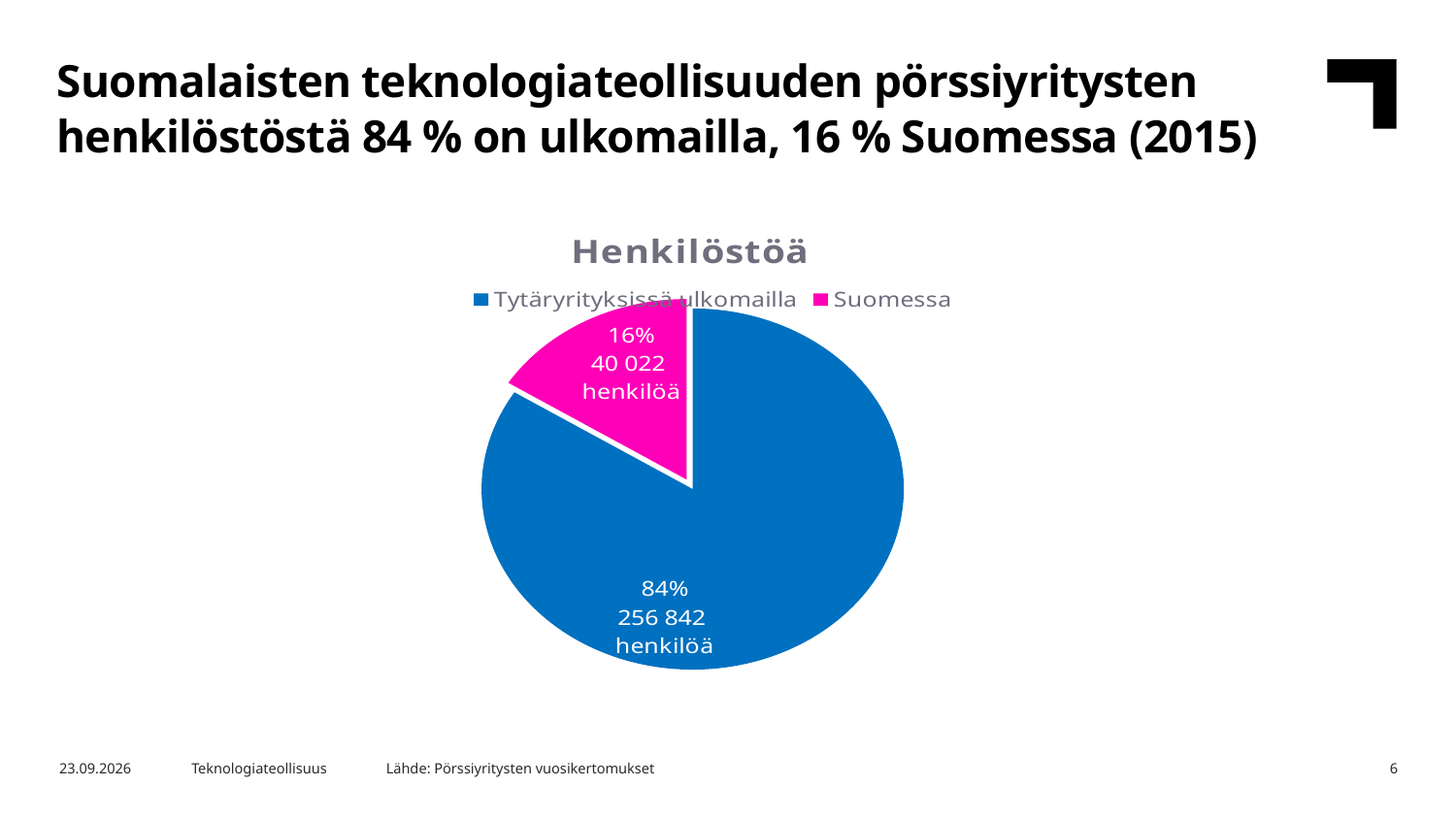
How many entries does the legend list? 2 What is the difference in headcount between 'Tytäryrityksissä ulkomailla' and 'Suomessa'? 216 820 Which slice is the largest in the pie chart? Tytäryrityksissä ulkomailla How many slices does the pie chart have? 2 What share of the pie does the 'Tytäryrityksissä ulkomailla' slice represent? 84% How many people does the 'Suomessa' slice represent? 40 022 henkilöä What kind of chart is shown on the slide? Pie chart What share of the pie does the 'Suomessa' slice represent? 16% How many people does the 'Tytäryrityksissä ulkomailla' slice represent? 256 842 henkilöä What is the title of the chart? Henkilöstöä Which slice is the smallest in the pie chart? Suomessa What colour is the 'Suomessa' slice? Magenta (pink)